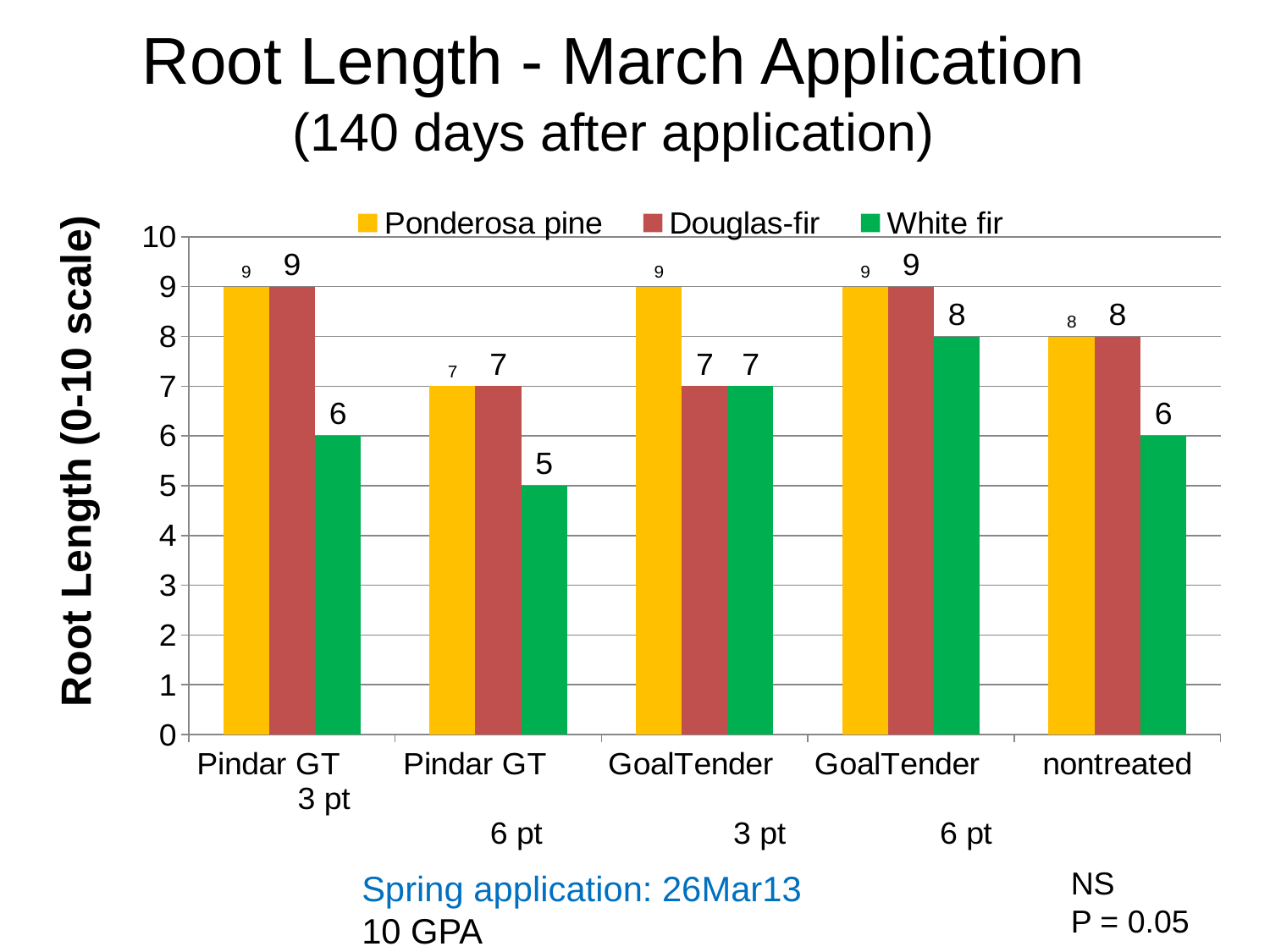
How many treatment categories are shown on the x axis? 5 What is the root length value for Ponderosa pine in the nontreated group? 8 What is the difference between the Ponderosa pine and White fir values under Pindar GT 3 pt? 3 What is the label of the y axis? Root Length (0-10 scale) Which series is shown in green in the legend? White fir Which treatment has the lowest White fir root length value? Pindar GT 6 pt Which is larger, the Douglas-fir value for Pindar GT 6 pt or the Douglas-fir value for GoalTender 6 pt? GoalTender 6 pt What is the root length value for White fir under the Pindar GT 6 pt treatment? 5 Which treatment has the highest White fir root length value? GoalTender 6 pt How many series does the legend list? 3 What kind of chart is shown on the slide? Bar chart What is the root length value for Douglas-fir under the GoalTender 3 pt treatment? 7